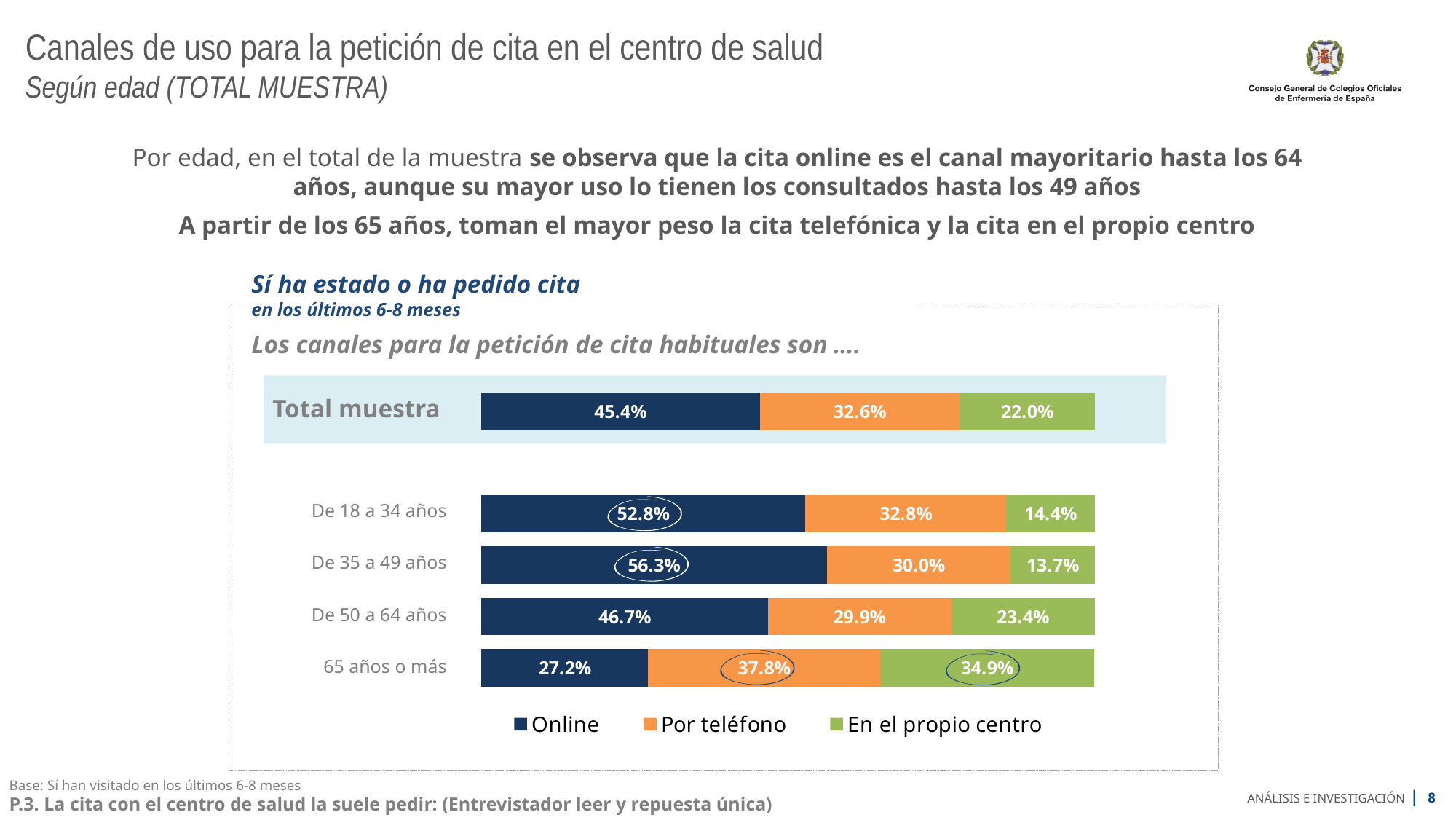
How many series does the legend list? 3 What is the total of the three segments in the '65 años o más' bar? 99.9% What is the 'En el propio centro' value for 'Total muestra'? 22.0% Which colour represents the 'Online' series in the legend? Dark blue Which has a larger 'Por teléfono' value: 'De 18 a 34 años' or 'De 35 a 49 años'? De 18 a 34 años How many age groups are plotted below the 'Total muestra' bar? 4 What is the 'Por teléfono' value for the '65 años o más' group? 37.8% What percentage of the 'De 35 a 49 años' group uses the Online channel? 56.3% What kind of chart is shown on the slide? Stacked bar chart Which age group has the highest Online value? De 35 a 49 años Which age group has the lowest 'En el propio centro' value? De 35 a 49 años What is the difference between the Online value for 'De 18 a 34 años' and for '65 años o más'? 25.6 percentage points